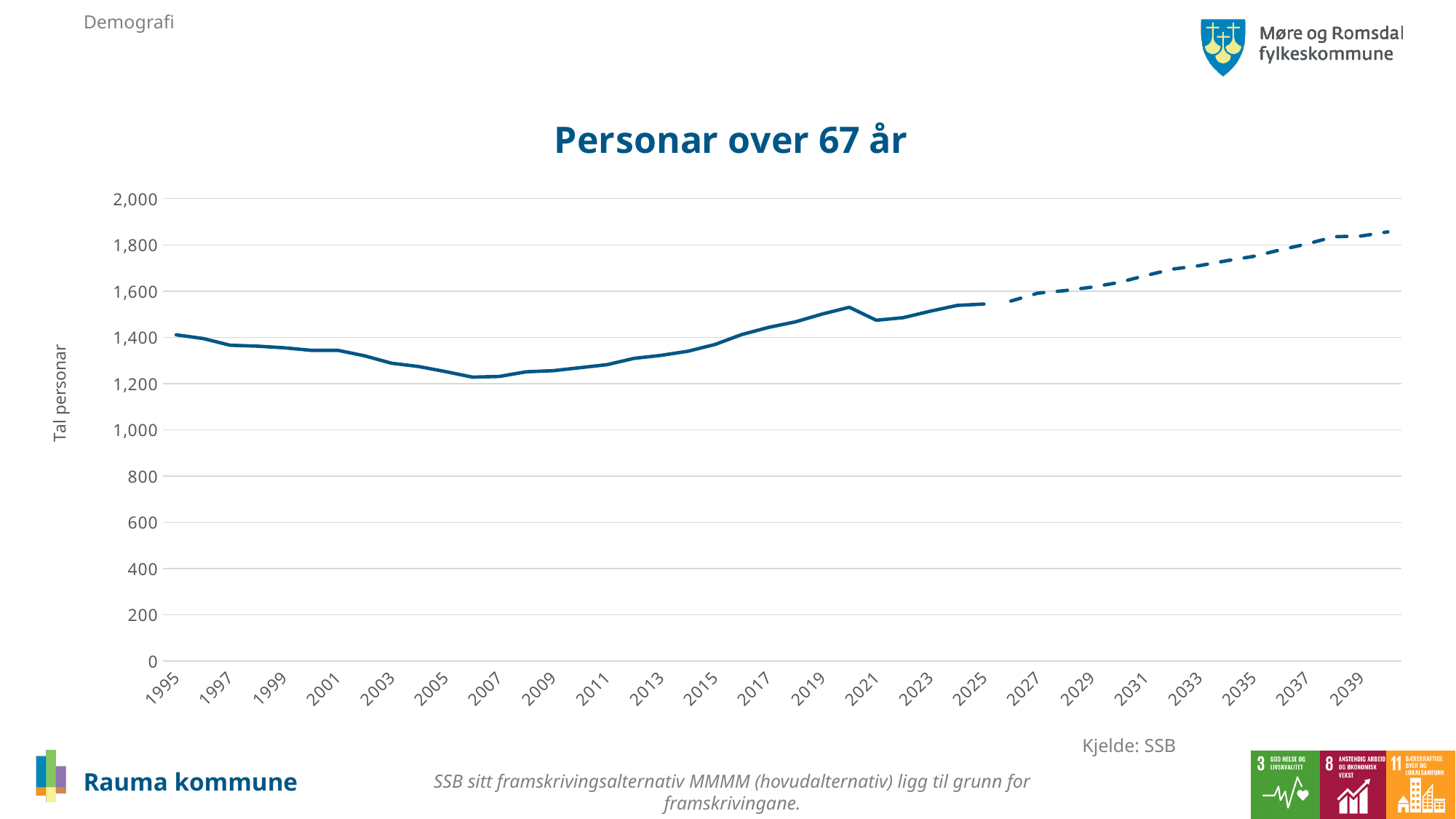
Is the value for 1995 greater or less than 1,600? less Is the value for 2001 greater or less than 1,400? less What is the label on the y axis of the chart? Tal personar What kind of chart is shown on the slide? line chart Which is larger, the value for 1995 or the value for 2025? 2025 Do the values rise or fall between 2007 and 2025? rise Is the value for 2025 greater or less than 1,600? less Do the values rise or fall between 1995 and 2007? fall What is the title of the chart? Personar over 67 år